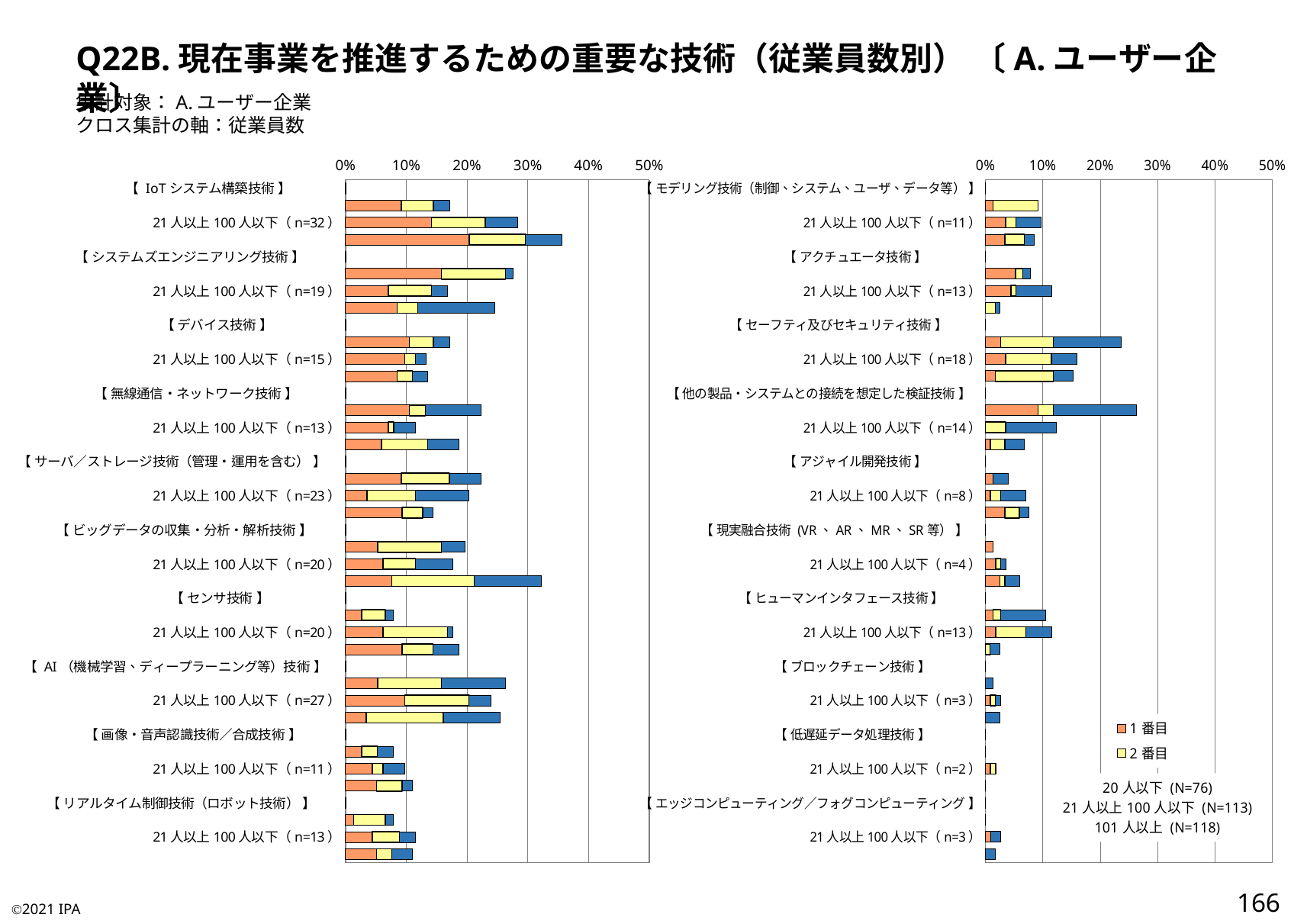
What kind of chart is used on this slide? Stacked horizontal bar chart How many technology categories are shown in the left chart? 10 What are the two legend entries shown on the slide? 1 番目, 2 番目 In the left chart, is the total bar for 20 人以下 under 【センサ技術】 greater or less than 10%? less In the right chart, is the total bar for 21 人以上 100 人以下 (n=3) under 【ブロックチェーン技術】 greater or less than 10%? less According to the note on the right chart, what is the N for 21 人以上 100 人以下? N=113 In the right chart, is the total bar for 20 人以下 under 【他の製品・システムとの接続を想定した検証技術】 greater or less than 20%? greater In the left chart under 【IoT システム構築技術】, which has the longer total bar: 20 人以下 or 101 人以上? 101 人以上 How many series does the legend on the right chart list? 2 How many technology categories are shown in the right chart? 10 In the left chart, which technology category contains the longest stacked bar? 【IoT システム構築技術】